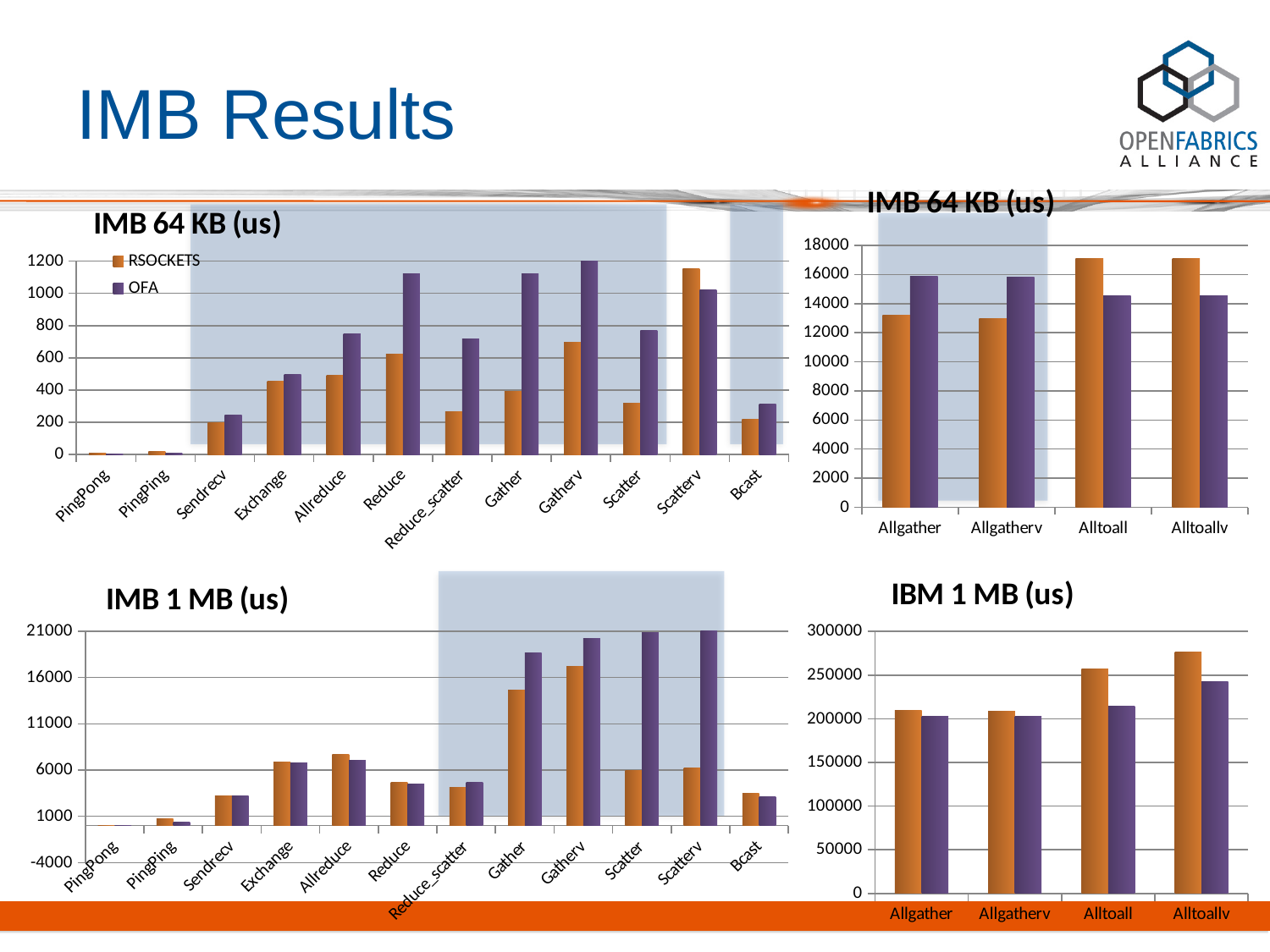
In the top-left chart titled IMB 64 KB (us), which is larger for Reduce, RSOCKETS or OFA? OFA In the top-left chart titled IMB 64 KB (us), is the OFA value for Reduce greater or less than 1000? greater In the bottom-left chart titled IMB 1 MB (us), is the RSOCKETS value for Gather greater or less than 11000? greater In the top-left chart titled IMB 64 KB (us), how many categories are shown on the x axis? 12 In the top-left chart titled IMB 64 KB (us), how many series does the legend list? 2 In the top-left chart titled IMB 64 KB (us), which category has the highest RSOCKETS value? Scatterv In the top-right chart titled IMB 64 KB (us), is the RSOCKETS value for Alltoall greater or less than 16000? greater In the top-right chart titled IMB 64 KB (us), which is larger for Allgather, RSOCKETS or OFA? OFA In the top-right chart titled IMB 64 KB (us), how many categories are shown on the x axis? 4 In the bottom-left chart titled IMB 1 MB (us), which category has the highest RSOCKETS value? Gatherv In the bottom-right chart titled IBM 1 MB (us), which category has the highest RSOCKETS value? Alltoallv What kind of chart is the bottom-right chart titled IBM 1 MB (us)? bar chart